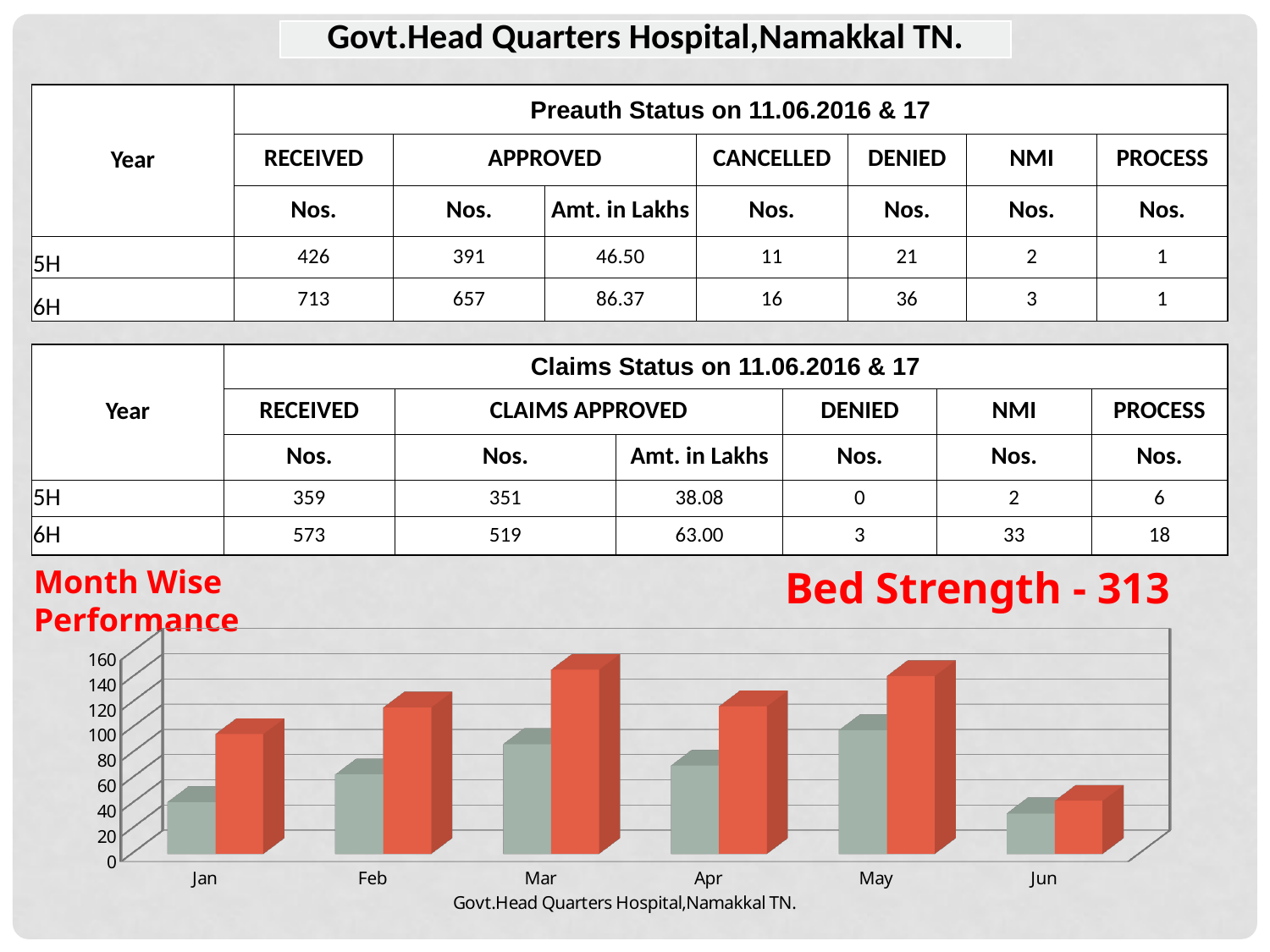
In the bar chart, which month has the highest grey bar? May What kind of chart is shown at the bottom of the slide? bar chart In the bar chart, which month has the lowest red bar? Jun In the bar chart, is the value of the red bar for Jun greater or less than 60? less In the bar chart, is the value of the red bar for Jan greater or less than 80? greater What is the first month shown on the x axis of the bar chart? Jan In the bar chart, is the value of the red bar for Mar greater or less than 120? greater How many months are shown on the x axis of the bar chart? 6 What text appears below the x axis of the bar chart? Govt.Head Quarters Hospital,Namakkal TN. In the bar chart, is the red bar larger for Mar or for Jun? Mar